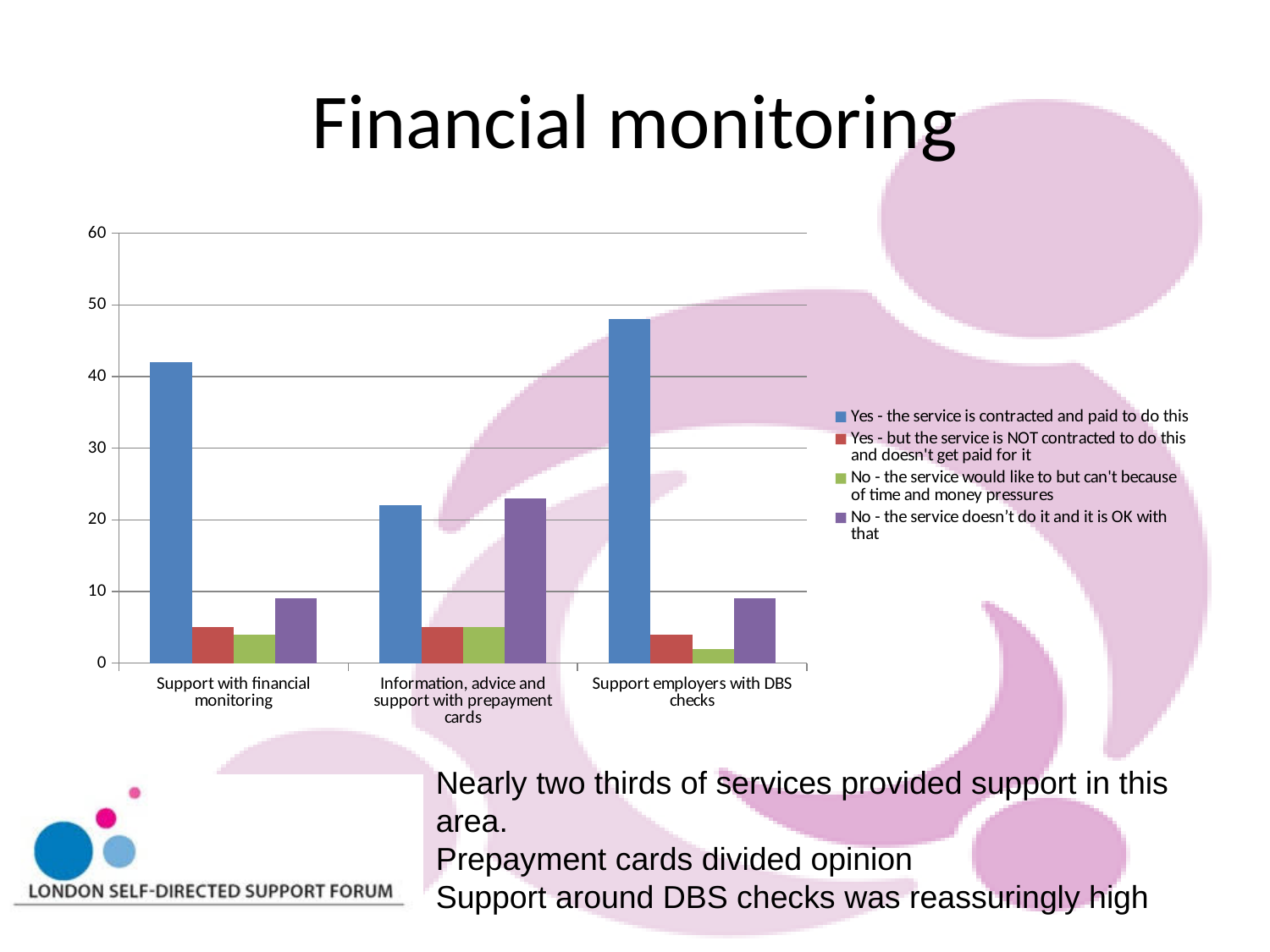
Which category has the lowest value for the series 'Yes - the service is contracted and paid to do this'? Information, advice and support with prepayment cards How many categories are shown on the x axis of the chart? 3 Is the value for 'Yes - the service is contracted and paid to do this' in the 'Support with financial monitoring' category greater or less than 40? greater Is the value for 'Yes - the service is contracted and paid to do this' in the 'Support employers with DBS checks' category greater or less than 50? less Is the value for 'No - the service doesn't do it and it is OK with that' in the 'Information, advice and support with prepayment cards' category greater or less than 20? greater What kind of chart is shown on the slide? bar chart In the 'Support employers with DBS checks' category, which is larger: the value for 'Yes - the service is contracted and paid to do this' or the value for 'No - the service doesn't do it and it is OK with that'? Yes - the service is contracted and paid to do this How many series does the chart's legend list? 4 Which category has the highest value for the series 'No - the service doesn't do it and it is OK with that'? Information, advice and support with prepayment cards Which category has the highest value for the series 'Yes - the service is contracted and paid to do this'? Support employers with DBS checks What is the title of the slide containing the chart? Financial monitoring